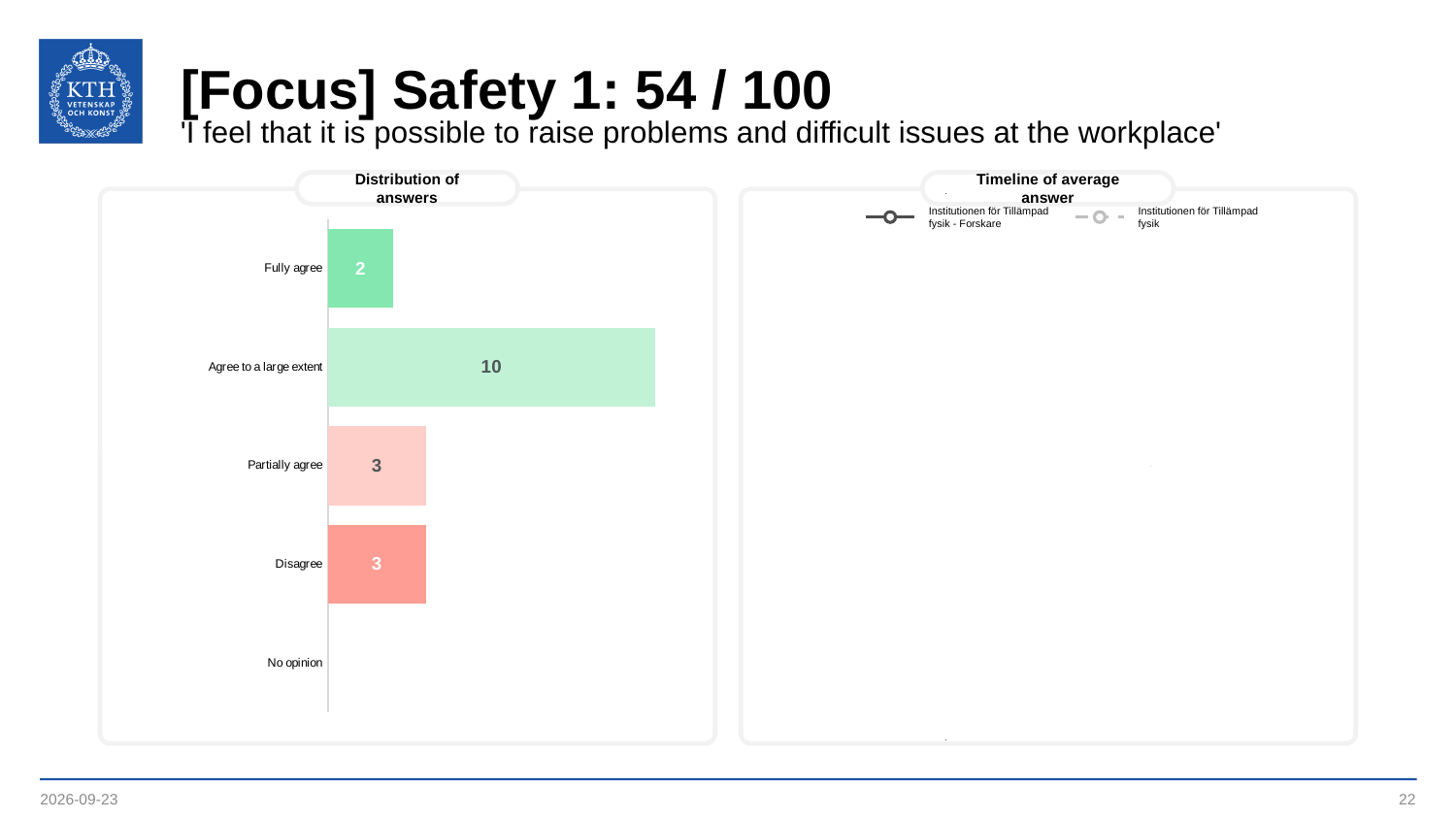
What kind of chart is the 'Distribution of answers' chart? Bar chart How many series does the legend of the 'Timeline of average answer' chart list? 2 In the 'Distribution of answers' chart, which is larger: 'Partially agree' or 'Fully agree'? Partially agree In the 'Distribution of answers' chart, what is the value for 'Disagree'? 3 In the 'Distribution of answers' chart, what is the value for 'Fully agree'? 2 What is the title of the chart on the left side of the slide? Distribution of answers In the 'Distribution of answers' chart, what is the difference between 'Agree to a large extent' and 'Fully agree'? 8 In the 'Distribution of answers' chart, which category has the highest value? Agree to a large extent How many categories are shown on the y axis of the 'Distribution of answers' chart? 5 In the 'Distribution of answers' chart, what is the value for 'Agree to a large extent'? 10 In the 'Distribution of answers' chart, what is the value for 'Partially agree'? 3 In the 'Distribution of answers' chart, what is the total of 'Fully agree' and 'Agree to a large extent'? 12